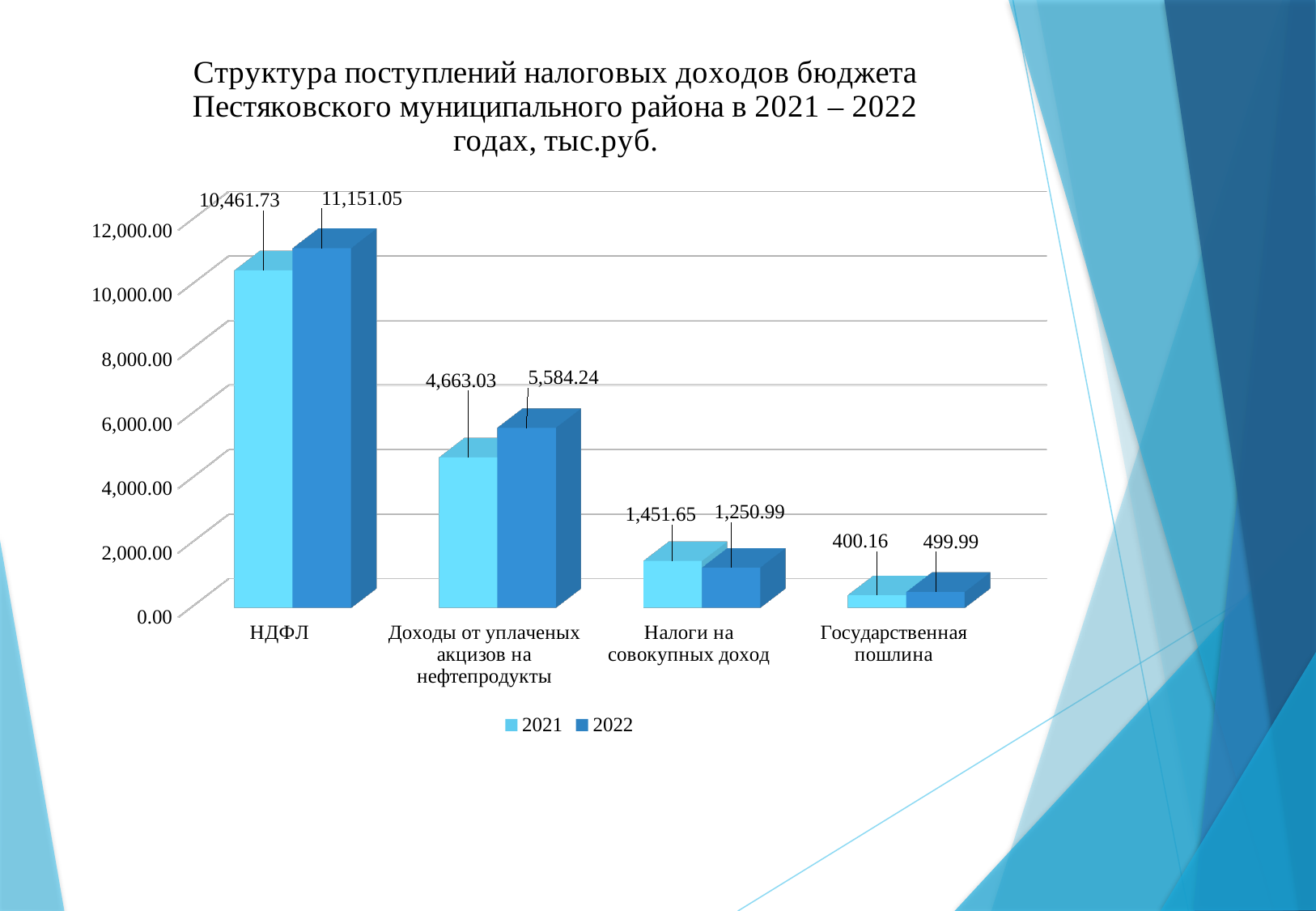
Which category has the lowest value in 2021? Государственная пошлина What is the value for НДФЛ in 2022? 11,151.05 What is the 2021 value for Государственная пошлина? 400.16 How many categories are shown on the x axis? 4 What is the difference between the 2021 and 2022 values for Налоги на совокупный доход? 200.66 What is the difference between the 2022 and 2021 values for НДФЛ? 689.32 Which is larger for Налоги на совокупный доход: the 2021 value or the 2022 value? 2021 What is the 2022 value for Доходы от уплаченых акцизов на нефтепродукты? 5,584.24 What kind of chart is shown on the slide? Bar chart Which category has the highest value in 2022? НДФЛ What is the value for НДФЛ in 2021? 10,461.73 How many series does the legend list? 2